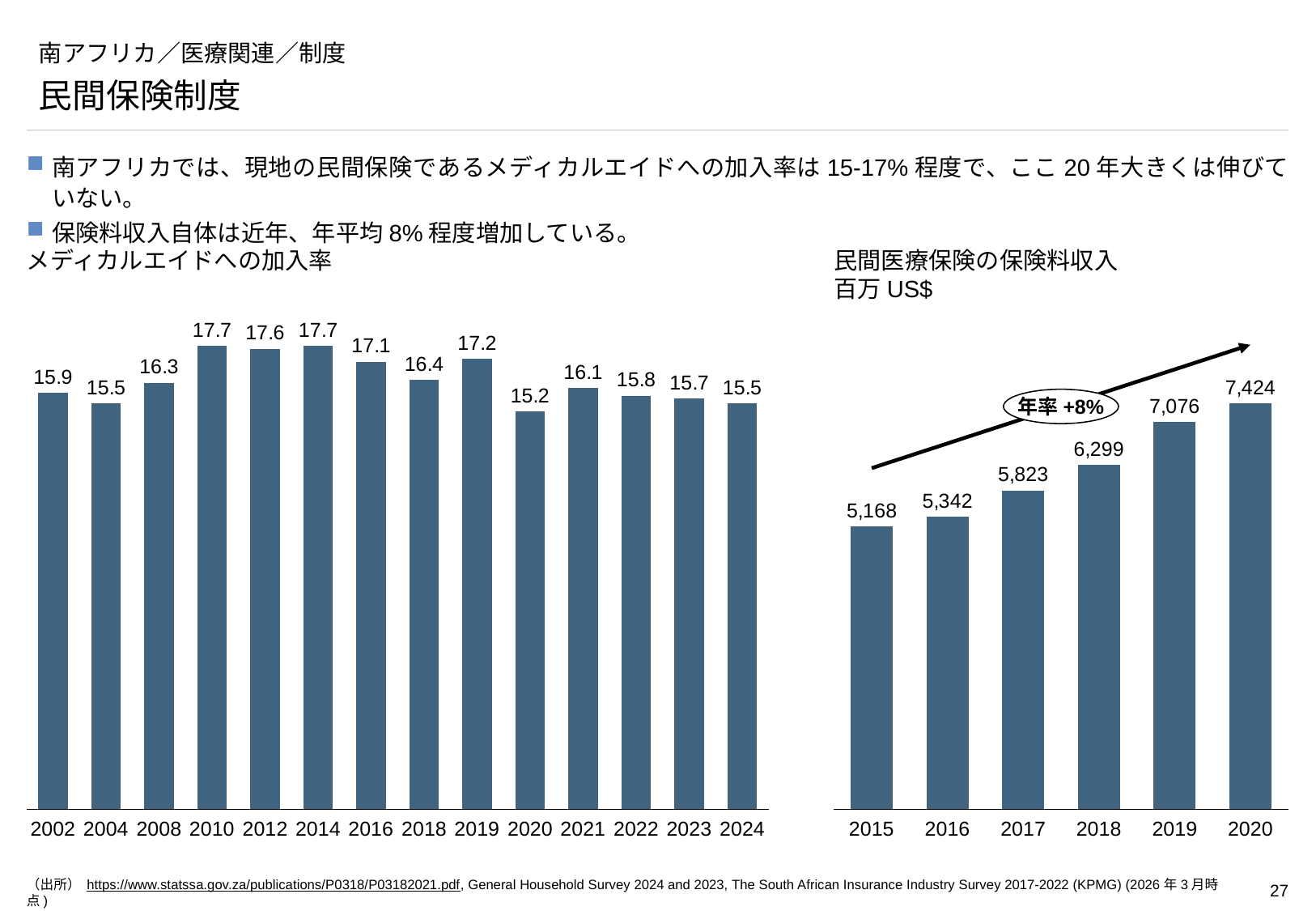
In the left chart (メディカルエイドへの加入率), which year has the lowest value? 2020 In the left chart (メディカルエイドへの加入率), which is larger, the value for 2016 or the value for 2018? 2016 In the right chart (民間医療保険の保険料収入), what is the value for 2017? 5,823 In the left chart (メディカルエイドへの加入率), what is the value for 2010? 17.7 In the left chart (メディカルエイドへの加入率), what is the difference between the values for 2002 and 2024? 0.4 In the right chart (民間医療保険の保険料収入), which year has the highest value? 2020 What type of chart is the right chart (民間医療保険の保険料収入)? bar chart In the left chart (メディカルエイドへの加入率), what is the value for 2020? 15.2 In the right chart (民間医療保険の保険料収入), what is the difference between the values for 2020 and 2019? 348 In the left chart (メディカルエイドへの加入率), how many years are plotted? 14 In the right chart (民間医療保険の保険料収入), which year has the lowest value? 2015 In the right chart (民間医療保険の保険料収入), do the values rise or fall from 2015 to 2020? rise